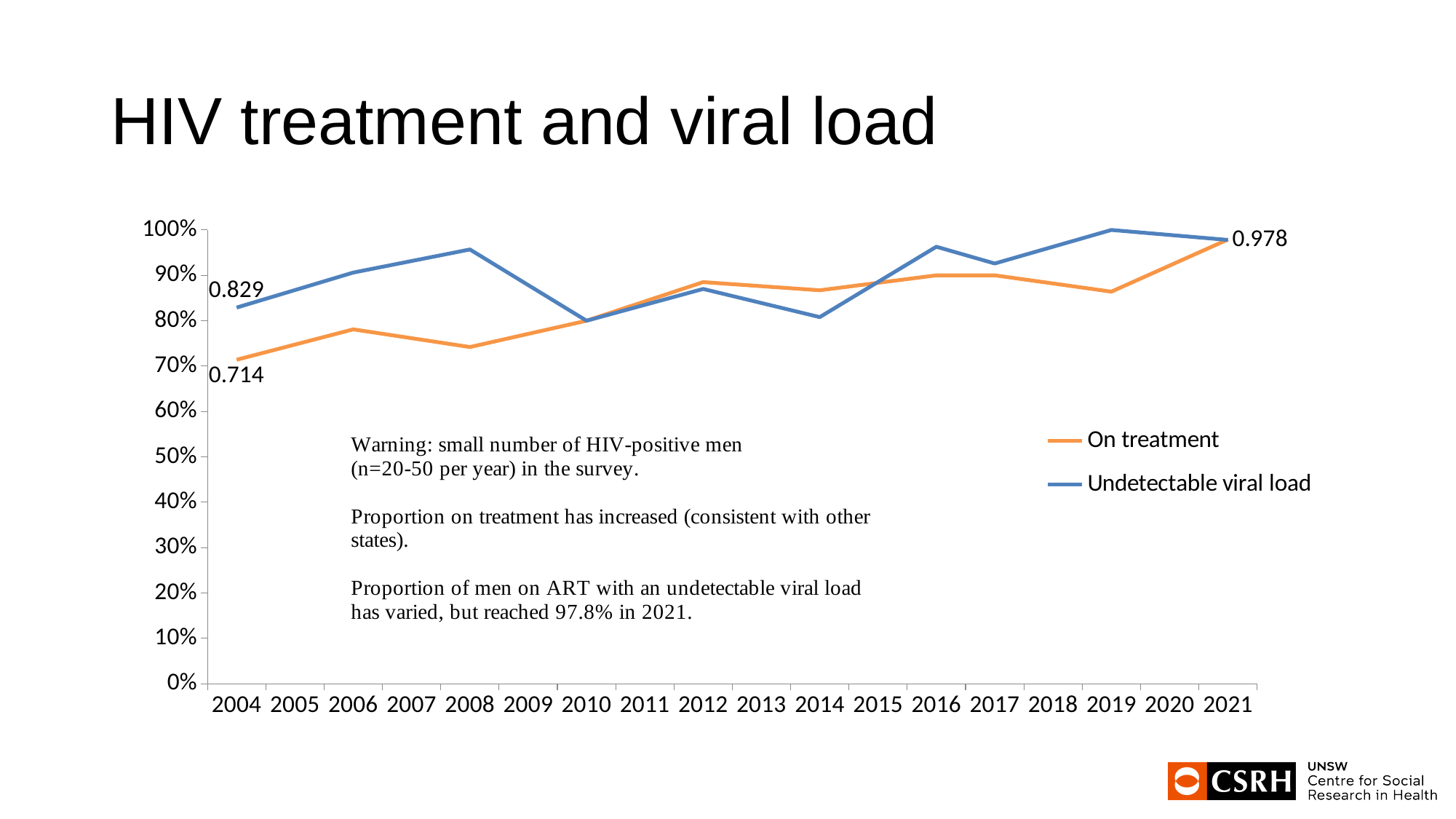
What is the value labelled for Undetectable viral load in 2004? 0.829 How many series does the legend list? 2 Is the value for Undetectable viral load in 2008 greater or less than 90%? greater What is the value labelled for On treatment in 2004? 0.714 What is the difference between the labelled 2004 values for Undetectable viral load and On treatment? 0.115 In which year does the Undetectable viral load series reach its highest value? 2019 In 2014, which series has the higher value, On treatment or Undetectable viral load? On treatment How many years are shown along the x axis? 18 In 2004, which series has the higher value, On treatment or Undetectable viral load? Undetectable viral load What kind of chart is shown on the slide? line chart Is the value for On treatment in 2008 greater or less than 80%? less Does the On treatment series generally rise or fall from 2004 to 2021? rise